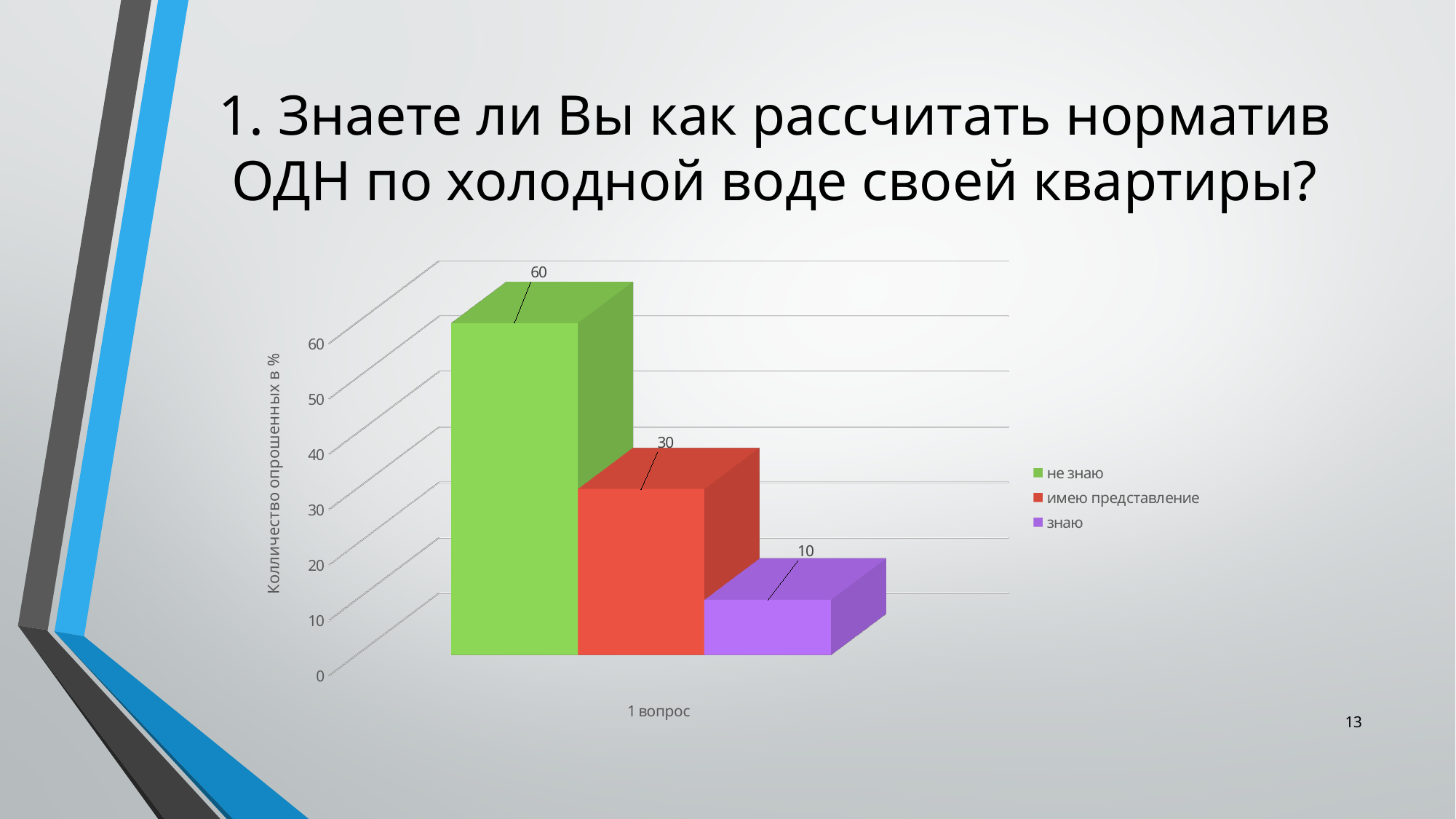
What is the label of the vertical axis? Колличество опрошенных в % What kind of chart is shown on the slide? bar chart Is the value for "не знаю" greater or less than 50? greater What is the value for "не знаю"? 60 What is the value for "имею представление"? 30 What is the difference between the values for "не знаю" and "имею представление"? 30 What is the difference between the values for "имею представление" and "знаю"? 20 What is the value for "знаю"? 10 How many series does the legend list? 3 Which series has the lowest value? знаю Which series has the highest value? не знаю Which is larger, the value for "имею представление" or the value for "знаю"? имею представление